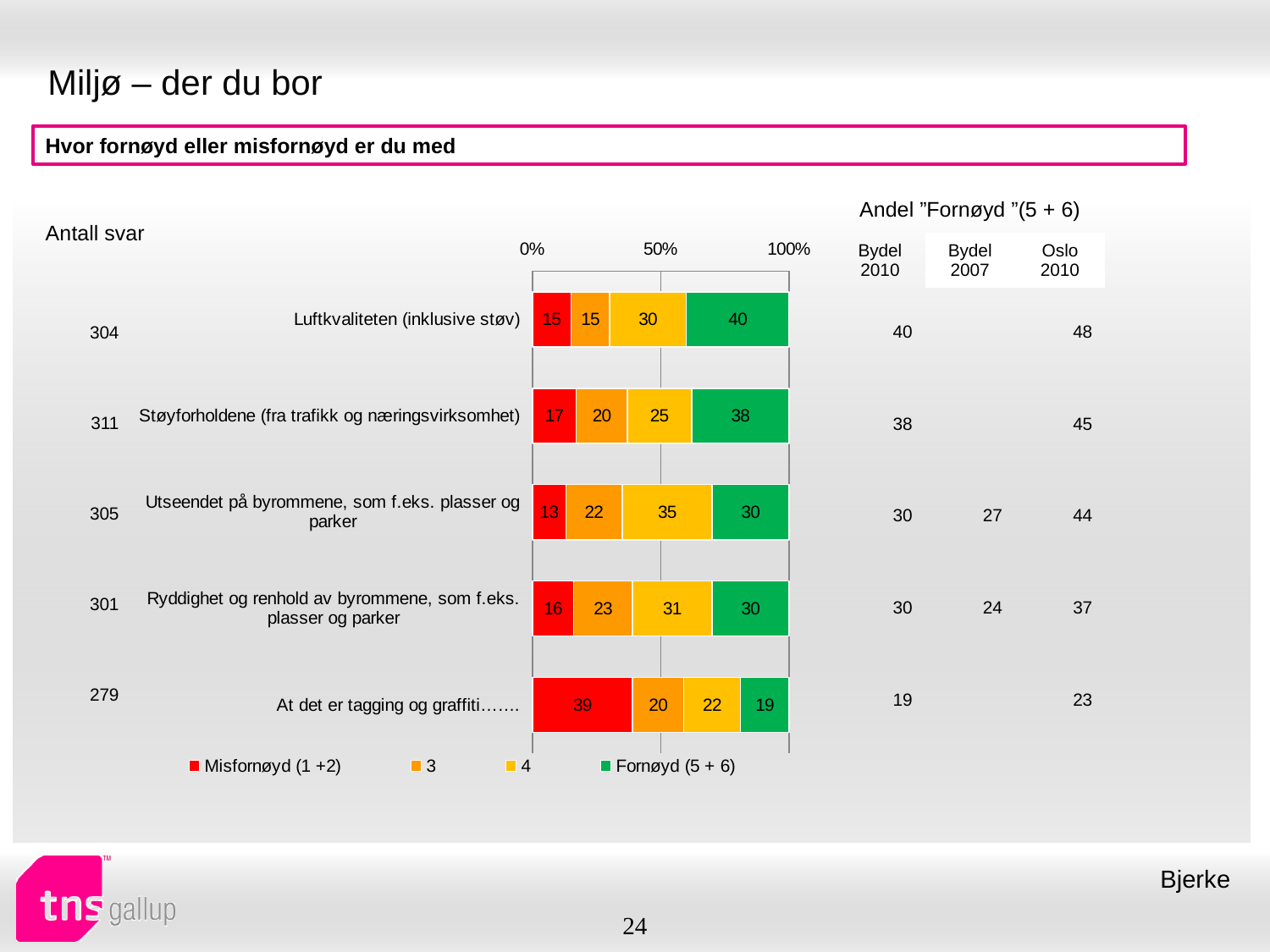
What is the value of the "Fornøyd (5 + 6)" segment for "Luftkvaliteten (inklusive støv)"? 40 Which is larger: the "Misfornøyd (1 +2)" value for "Støyforholdene (fra trafikk og næringsvirksomhet)" or for "Utseendet på byrommene, som f.eks. plasser og parker"? Støyforholdene (fra trafikk og næringsvirksomhet) How many series does the legend list? 4 What is the value of the "Misfornøyd (1 +2)" segment for "At det er tagging og graffiti…"? 39 What is the difference between the "Fornøyd (5 + 6)" values for "Luftkvaliteten (inklusive støv)" and "At det er tagging og graffiti…"? 21 Which category has the lowest "Fornøyd (5 + 6)" value? At det er tagging og graffiti… How many categories are shown in the chart? 5 What kind of chart is shown on the slide? Stacked bar chart What is the total of the stacked bar for "Ryddighet og renhold av byrommene, som f.eks. plasser og parker"? 100 What is the value of the "4" segment for "Utseendet på byrommene, som f.eks. plasser og parker"? 35 What colour represents the "Fornøyd (5 + 6)" series in the chart? Green Which category has the highest "Fornøyd (5 + 6)" value? Luftkvaliteten (inklusive støv)